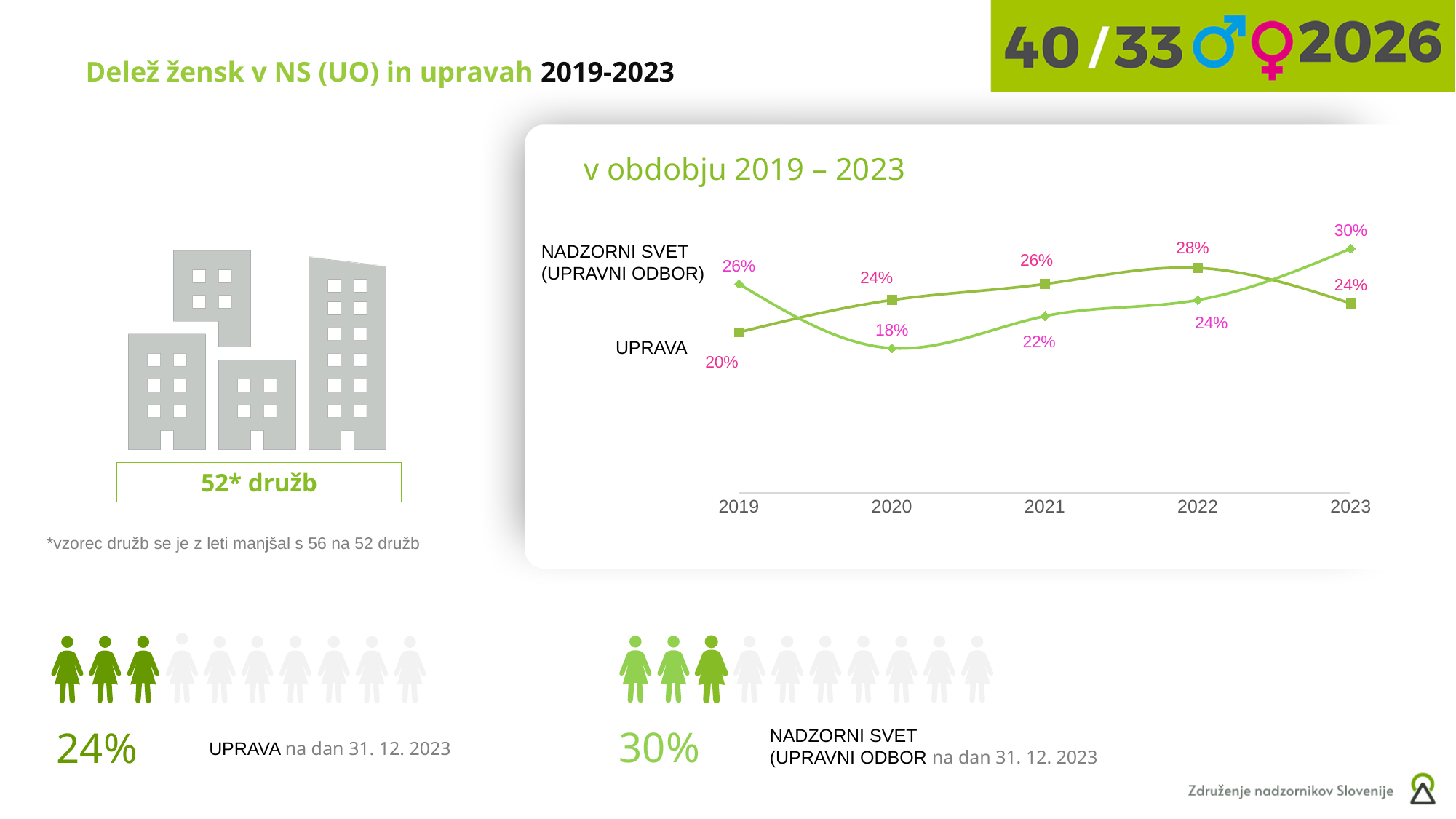
What is the value for UPRAVA in 2019? 20% How many years are plotted along the x axis of the chart? 5 In which year is the NADZORNI SVET (UPRAVNI ODBOR) series at its highest? 2023 In which year is the NADZORNI SVET (UPRAVNI ODBOR) series at its lowest? 2020 In 2021, which series has the higher value, UPRAVA or NADZORNI SVET (UPRAVNI ODBOR)? UPRAVA What is the difference between the NADZORNI SVET (UPRAVNI ODBOR) value and the UPRAVA value in 2023? 6 percentage points What is the value for UPRAVA in 2022? 28% What kind of chart is shown on the slide? line chart What is the value for NADZORNI SVET (UPRAVNI ODBOR) in 2020? 18% How many series are plotted in the chart? 2 In which year is the UPRAVA series at its highest? 2022 What is the value for NADZORNI SVET (UPRAVNI ODBOR) in 2023? 30%